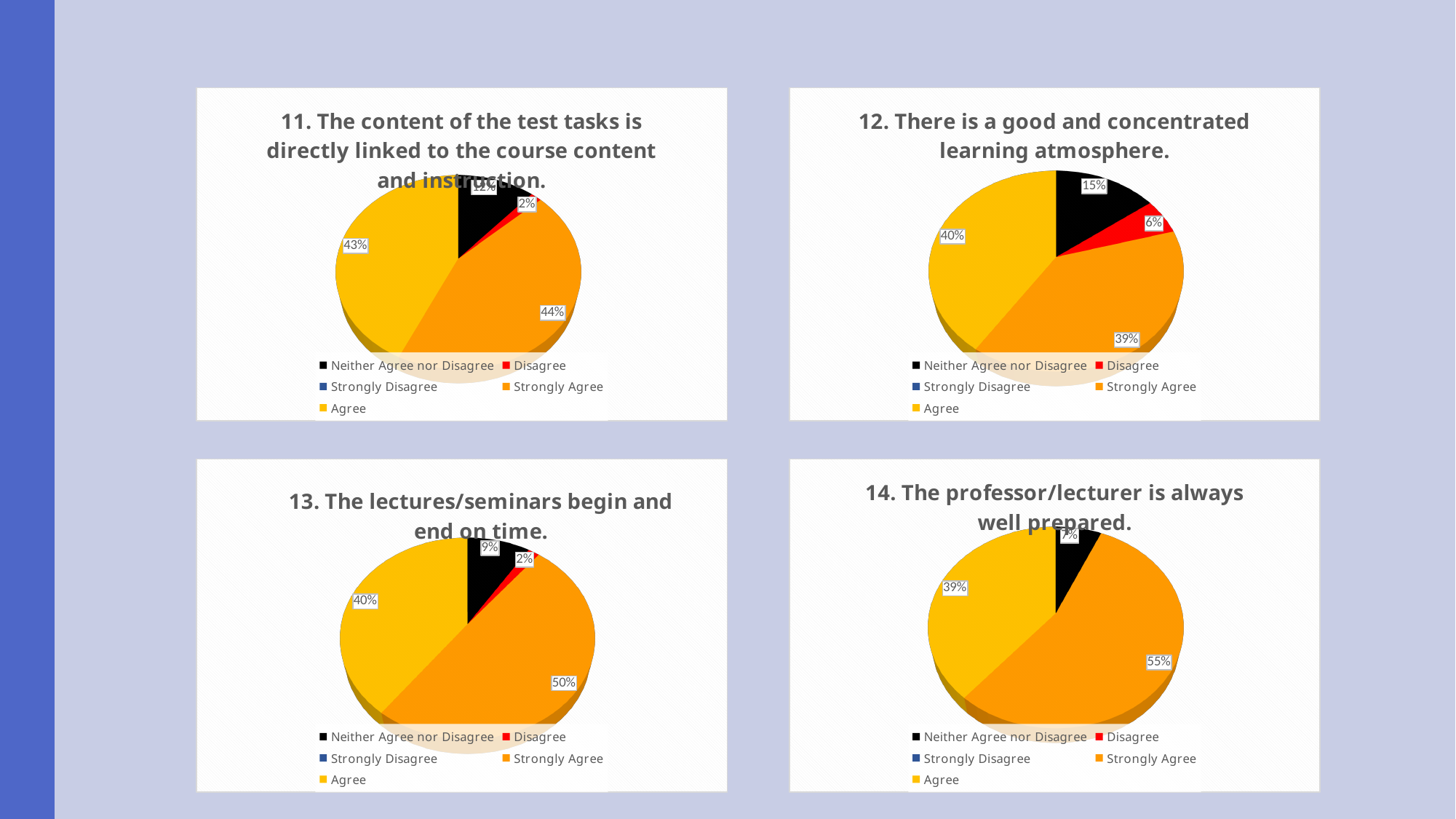
In the chart titled "12. There is a good and concentrated learning atmosphere.", which is larger, Neither Agree nor Disagree or Disagree? Neither Agree nor Disagree In the chart titled "13. The lectures/seminars begin and end on time.", how many percentage points larger is Strongly Agree than Agree? 10% What type of chart is used for "14. The professor/lecturer is always well prepared."? Pie chart In the chart titled "14. The professor/lecturer is always well prepared.", what share of responses is Agree? 39% In the chart titled "11. The content of the test tasks is directly linked to the course content and instruction.", what share of responses is Disagree? 2% In the chart titled "13. The lectures/seminars begin and end on time.", what share of responses is Strongly Agree? 50% In the chart titled "12. There is a good and concentrated learning atmosphere.", what share of responses is Disagree? 6% In the chart titled "13. The lectures/seminars begin and end on time.", which response category has the smallest labelled slice? Disagree In the chart titled "12. There is a good and concentrated learning atmosphere.", what share of responses is Neither Agree nor Disagree? 15% In the chart titled "14. The professor/lecturer is always well prepared.", which response category has the largest slice? Strongly Agree In the chart titled "11. The content of the test tasks is directly linked to the course content and instruction.", is the Strongly Agree share greater or less than 40%? greater How many response categories does the legend list in the chart titled "13. The lectures/seminars begin and end on time."? 5